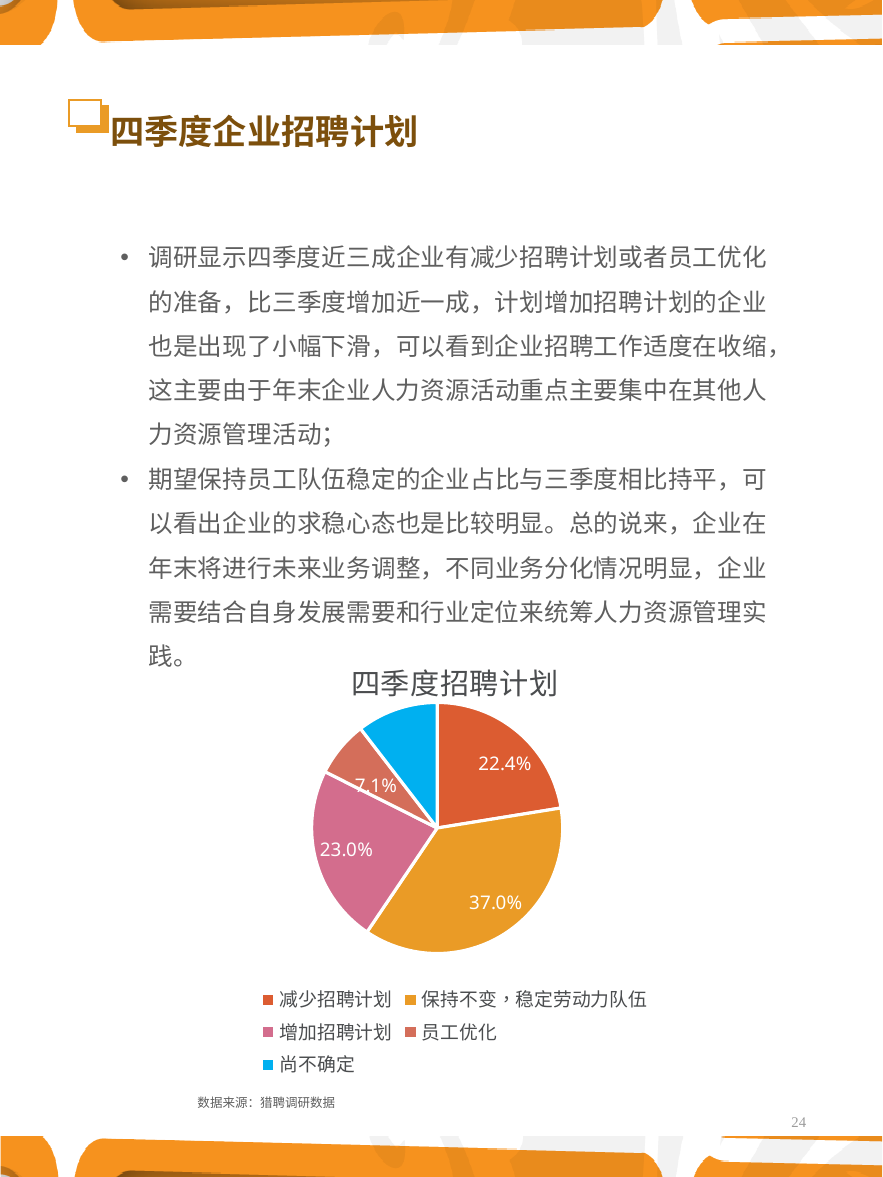
What kind of chart is shown on the slide? Pie chart What colour is the slice for 尚不确定? Blue Which category has the smallest slice of the pie? 员工优化 What percentage is shown for 员工优化? 7.1% How many categories does the legend list? 5 Which category has the largest slice of the pie? 保持不变，稳定劳动力队伍 What share of the pie is labelled for 保持不变，稳定劳动力队伍? 37.0% How many percentage points larger is 保持不变，稳定劳动力队伍 than 减少招聘计划? 14.6 percentage points What is the title of the chart? 四季度招聘计划 Which is larger, the share for 增加招聘计划 or the share for 减少招聘计划? 增加招聘计划 What percentage is shown for 增加招聘计划? 23.0% What percentage is shown for 减少招聘计划? 22.4%